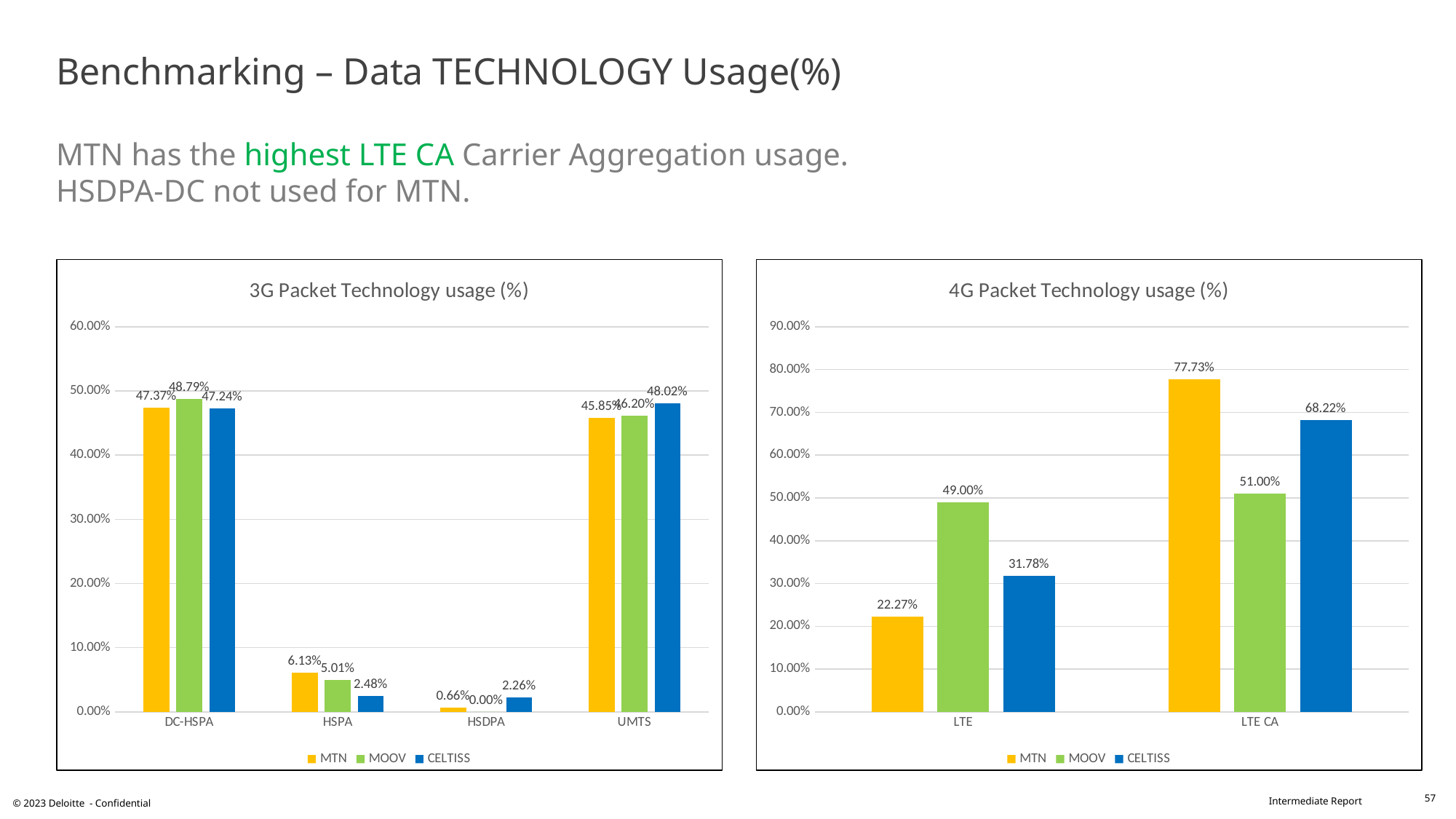
What kind of chart is the 4G Packet Technology usage (%) chart? Bar chart In the 3G Packet Technology usage (%) chart, what is the value for CELTISS in the HSDPA category? 2.26% In the 4G Packet Technology usage (%) chart, which operator has the highest value in the LTE CA category? MTN In the 3G Packet Technology usage (%) chart, which is larger for HSPA: the MTN value or the CELTISS value? MTN In the 4G Packet Technology usage (%) chart, what is the value for MTN in the LTE CA category? 77.73% In the 4G Packet Technology usage (%) chart, what is the difference between the MTN values for LTE CA and LTE? 55.46% In the 3G Packet Technology usage (%) chart, what is the value for MOOV in the DC-HSPA category? 48.79% How many categories are shown on the x axis of the 3G Packet Technology usage (%) chart? 4 In the 4G Packet Technology usage (%) chart, is the MOOV value for LTE CA greater or less than 60.00%? less How many series does the legend of the 4G Packet Technology usage (%) chart list? 3 In the 3G Packet Technology usage (%) chart, which operator has the lowest value in the HSDPA category? MOOV In the 4G Packet Technology usage (%) chart, what is the value for CELTISS in the LTE category? 31.78%